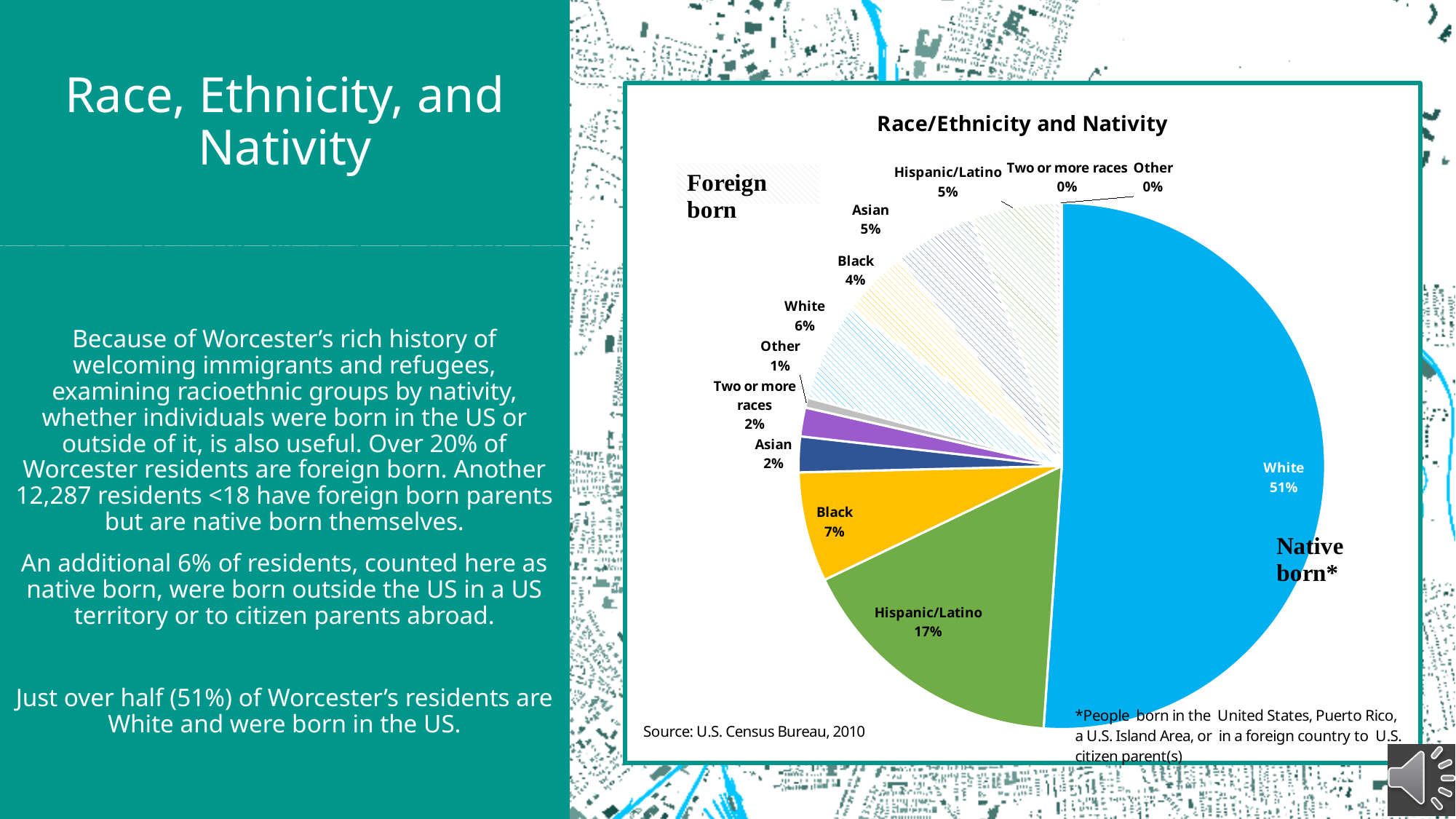
What share of the pie is the foreign born White slice? 6% What is the combined share of the native born White and native born Hispanic/Latino slices? 68% What share of the pie is the native born Hispanic/Latino slice? 17% Which is larger, the foreign born Black slice or the foreign born Asian slice? foreign born Asian What is the title of the chart? Race/Ethnicity and Nativity What share of the pie is the foreign born Asian slice? 5% What share of the pie is the native born White slice? 51% What kind of chart is shown on the slide? pie chart How many labeled slices does the pie chart have? 12 What share of the pie is the native born Black slice? 7% Which slice of the pie is the largest? Native born White What is the difference between the native born Hispanic/Latino share and the native born Black share? 10%